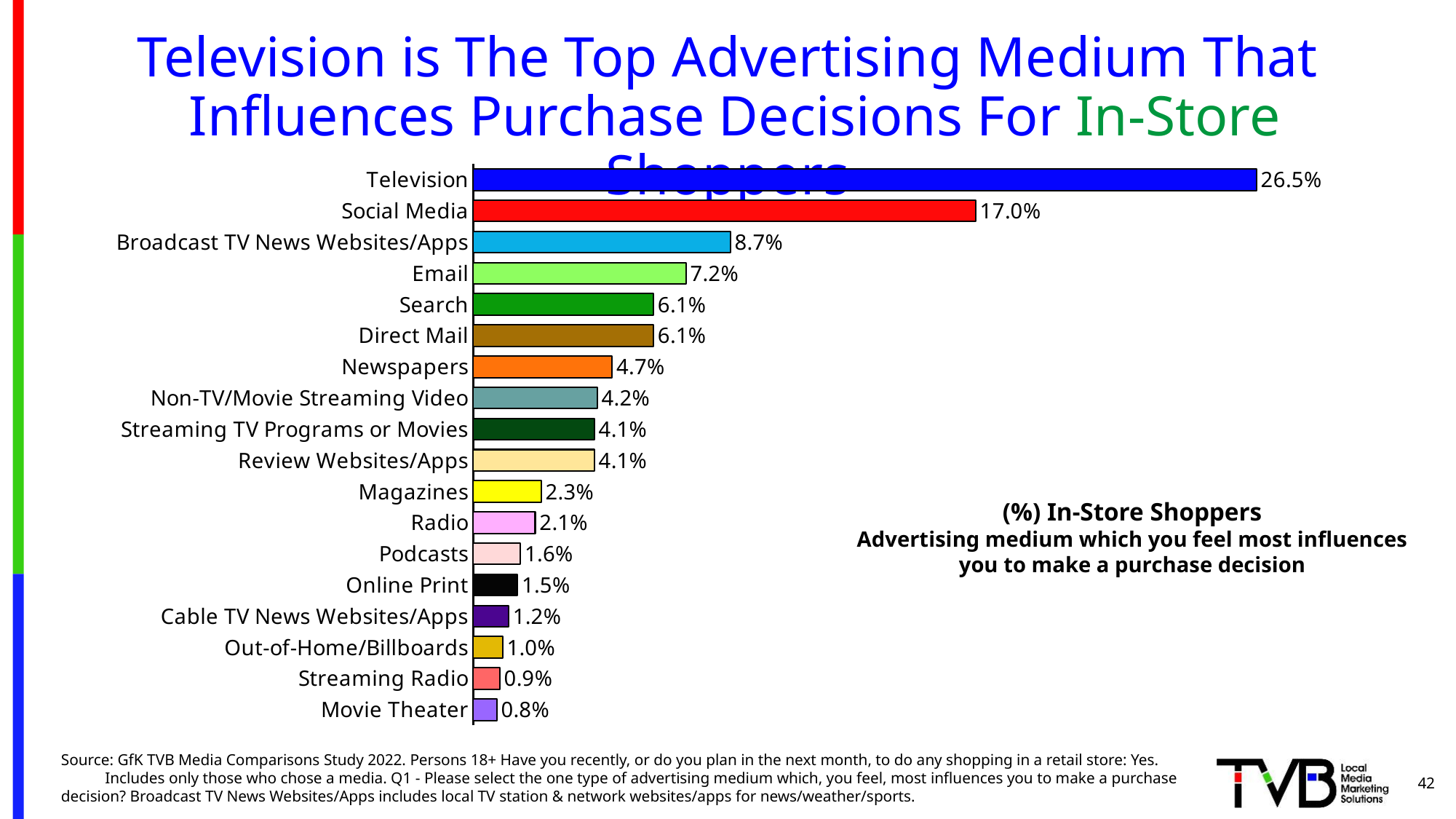
What is the value shown for Podcasts? 1.6% What colour is the bar for Social Media? Red Which has a larger value, Magazines or Radio? Magazines What is the value shown for Broadcast TV News Websites/Apps? 8.7% What kind of chart is shown on the slide? Bar chart What is the difference between the values for Television and Social Media? 9.5% What is the difference between the values for Email and Newspapers? 2.5% Which advertising medium has the highest value on the chart? Television What is the value shown for Social Media? 17.0% Which advertising medium has the lowest value on the chart? Movie Theater How many advertising media (categories) are shown on the chart? 18 What percentage of in-store shoppers chose Television as the advertising medium that most influences their purchase decision? 26.5%